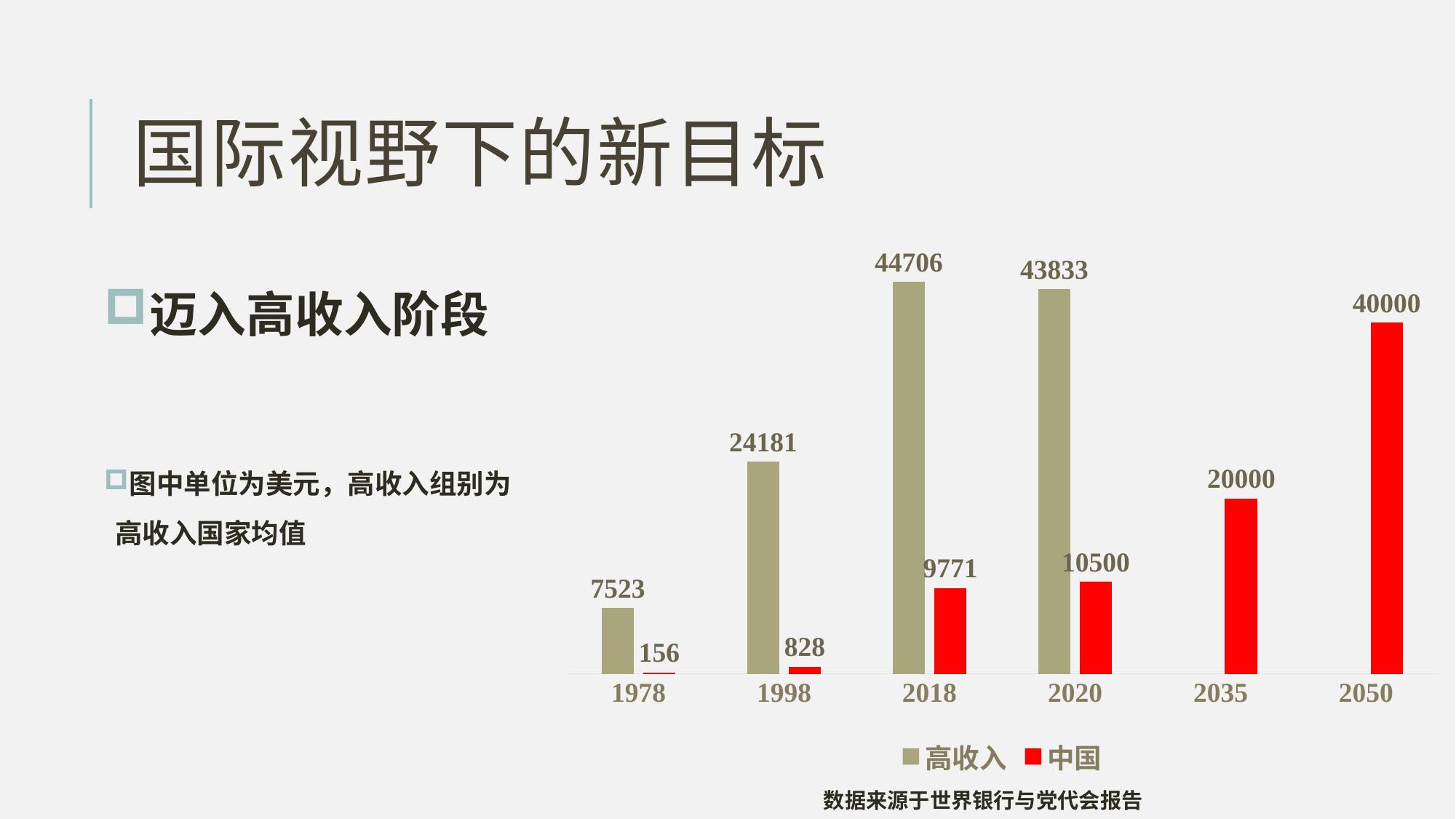
How many years are shown on the x axis? 6 Does the 中国 series rise or fall from 1978 to 2050? rise What kind of chart is shown on the slide? bar chart How many series does the legend list? 2 What colour are the bars for the 中国 series? red In which year is the 高收入 series highest? 2018 What is the value for 中国 in 2020? 10500 What is the value for 高收入 in 1998? 24181 What is the value for 中国 in 1978? 156 In which year is the 中国 series lowest? 1978 What is the difference between the 高收入 and 中国 values in 2018? 34935 Which is larger in 2020, the 高收入 value or the 中国 value? 高收入